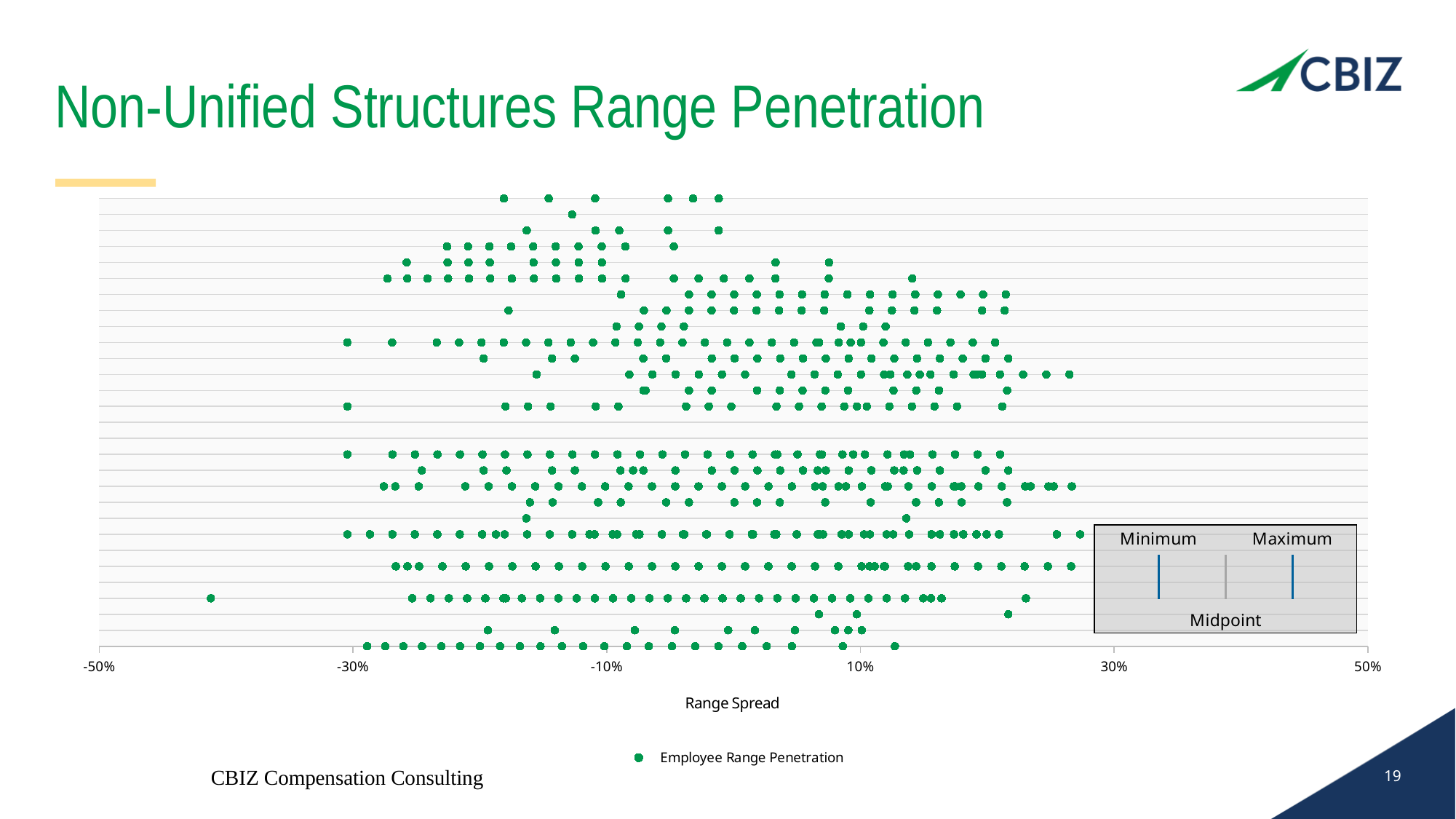
How many series does the chart legend list? 1 What kind of chart is shown on the slide? Scatter chart What is the title of the horizontal axis of the chart? Range Spread What is the name of the series shown in the chart legend? Employee Range Penetration Is the leftmost plotted point on the chart greater or less than -50%? greater Is the leftmost plotted point on the chart greater or less than -30%? less Is the rightmost plotted point on the chart greater or less than 30%? less